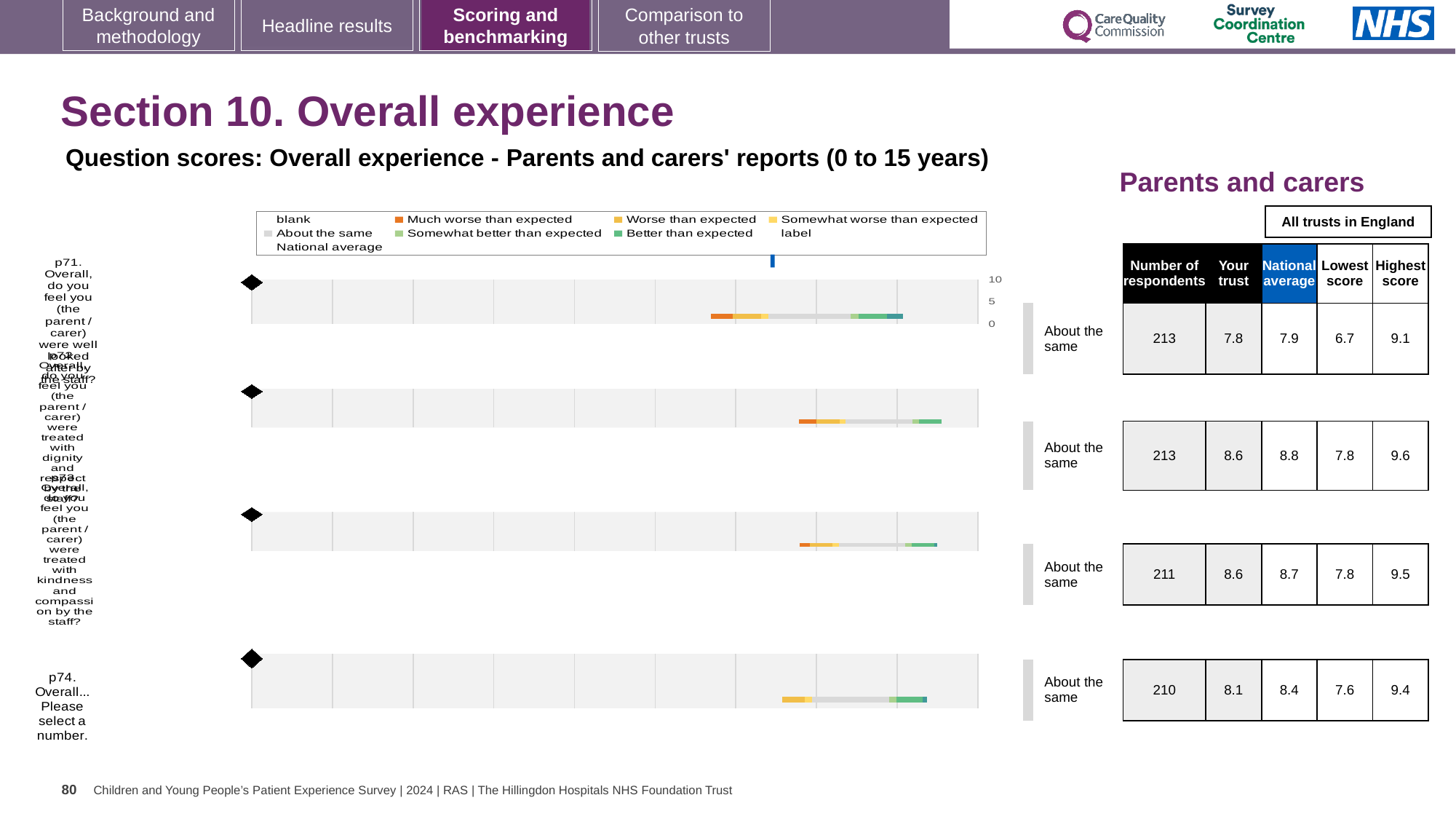
What is the national average score for question p72? 8.8 For question p71, which is larger: the 'Your trust' score or the national average? National average Which question has the lowest 'Your trust' score? p71 What is the difference between the national average and the 'Your trust' score for question p74? 0.3 What is the highest score for question p73? 9.5 What is the 'Your trust' score for question p71? 7.8 What is the lowest score for question p74? 7.6 What benchmark category is shown for question p72? About the same How many respondents answered question p74? 210 How many survey questions (rows) are plotted in the chart? 4 What kind of chart is shown on the slide? bar chart What is the title of the chart? Question scores: Overall experience - Parents and carers' reports (0 to 15 years)